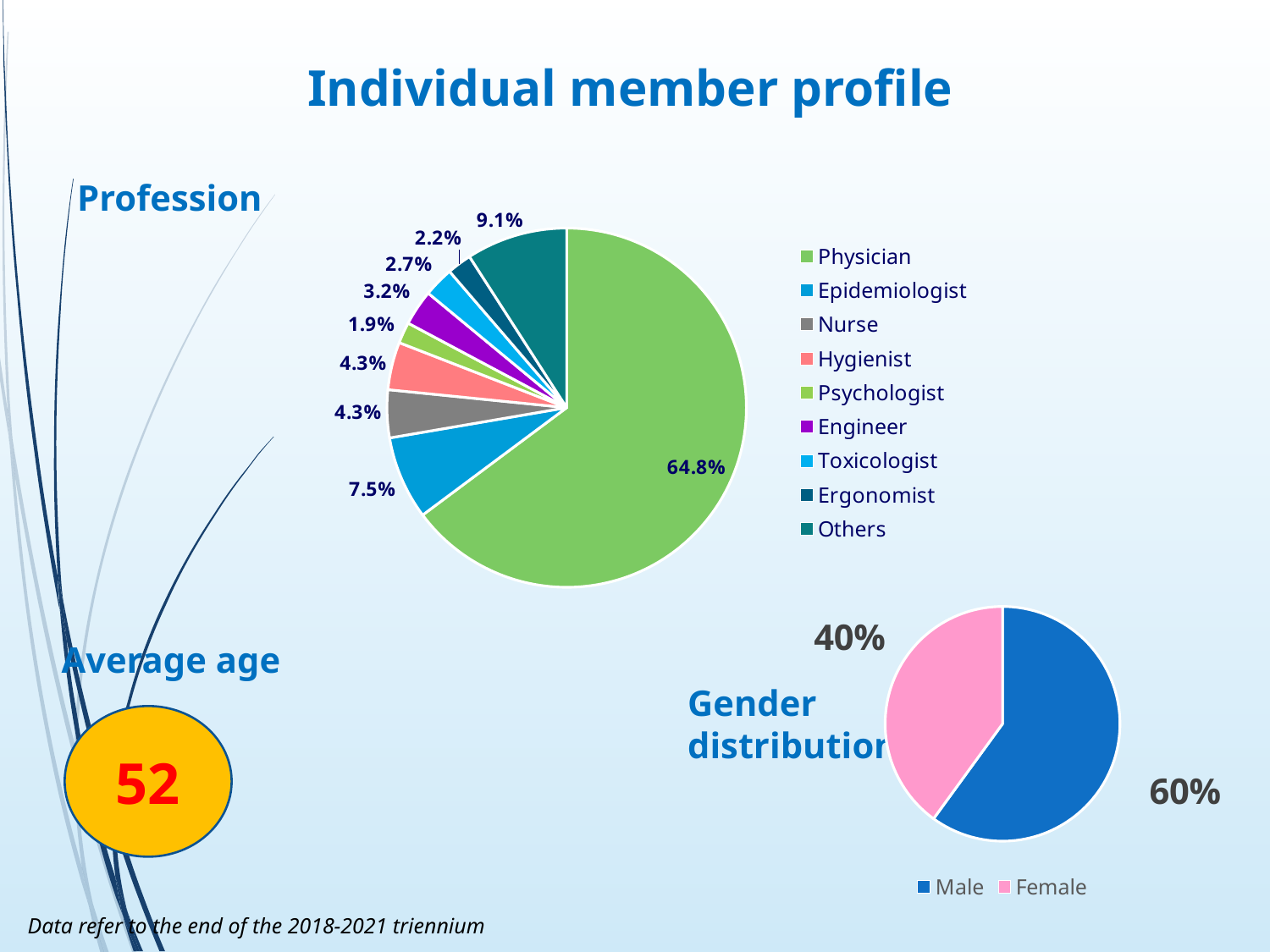
In the Profession pie chart, what is the difference between the Engineer share and the Toxicologist share? 0.5% In the Profession pie chart, what percentage of members are Physicians? 64.8% In the Profession pie chart, which is larger, the Ergonomist share or the Toxicologist share? Toxicologist In the Gender distribution chart, what is the difference between the Male and Female shares? 20% In the Profession pie chart, which profession has the largest share? Physician In the Profession pie chart, which profession has the smallest share? Psychologist In the Profession pie chart, what percentage of members are Epidemiologists? 7.5% What type of chart is used for the Profession data? Pie chart In the Gender distribution chart, what percentage of members are Male? 60% In the Profession pie chart, what share is labelled for Others? 9.1% In the Gender distribution chart, what colour represents Female? Pink How many professions are listed in the legend of the Profession pie chart? 9